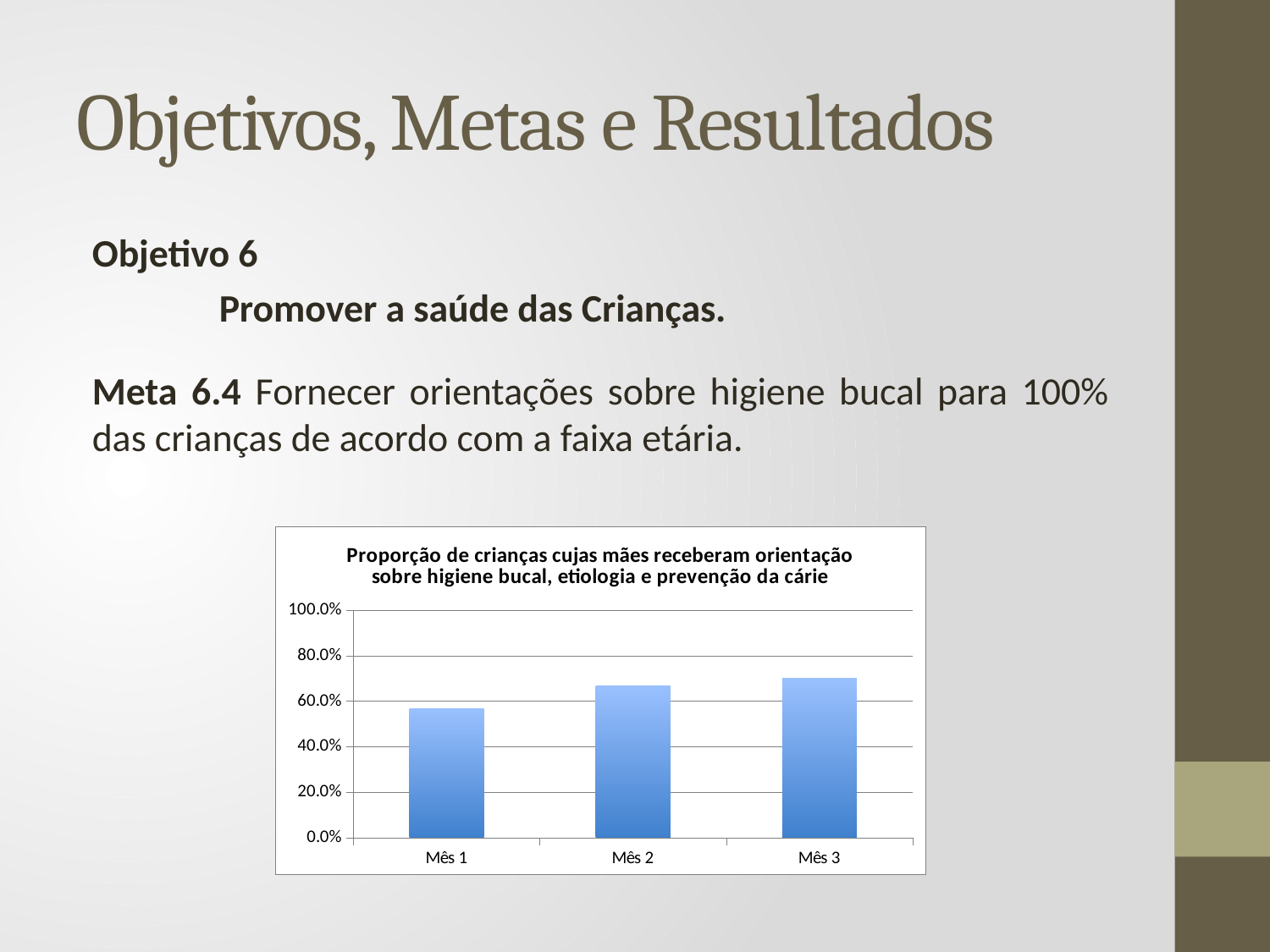
Which is larger, the value for Mês 1 or the value for Mês 2? Mês 2 What is the title of the chart? Proporção de crianças cujas mães receberam orientação sobre higiene bucal, etiologia e prevenção da cárie What kind of chart is shown on the slide? bar chart Is the value for Mês 3 greater or less than 60.0%? greater How many categories (months) are plotted on the chart? 3 Is the value for Mês 2 greater or less than 60.0%? greater Is the value for Mês 1 greater or less than 40.0%? greater Which month has the highest value on the chart? Mês 3 What is the highest value shown on the chart's vertical axis? 100.0% Which month has the lowest value on the chart? Mês 1 Do the values rise or fall from Mês 1 to Mês 3? rise